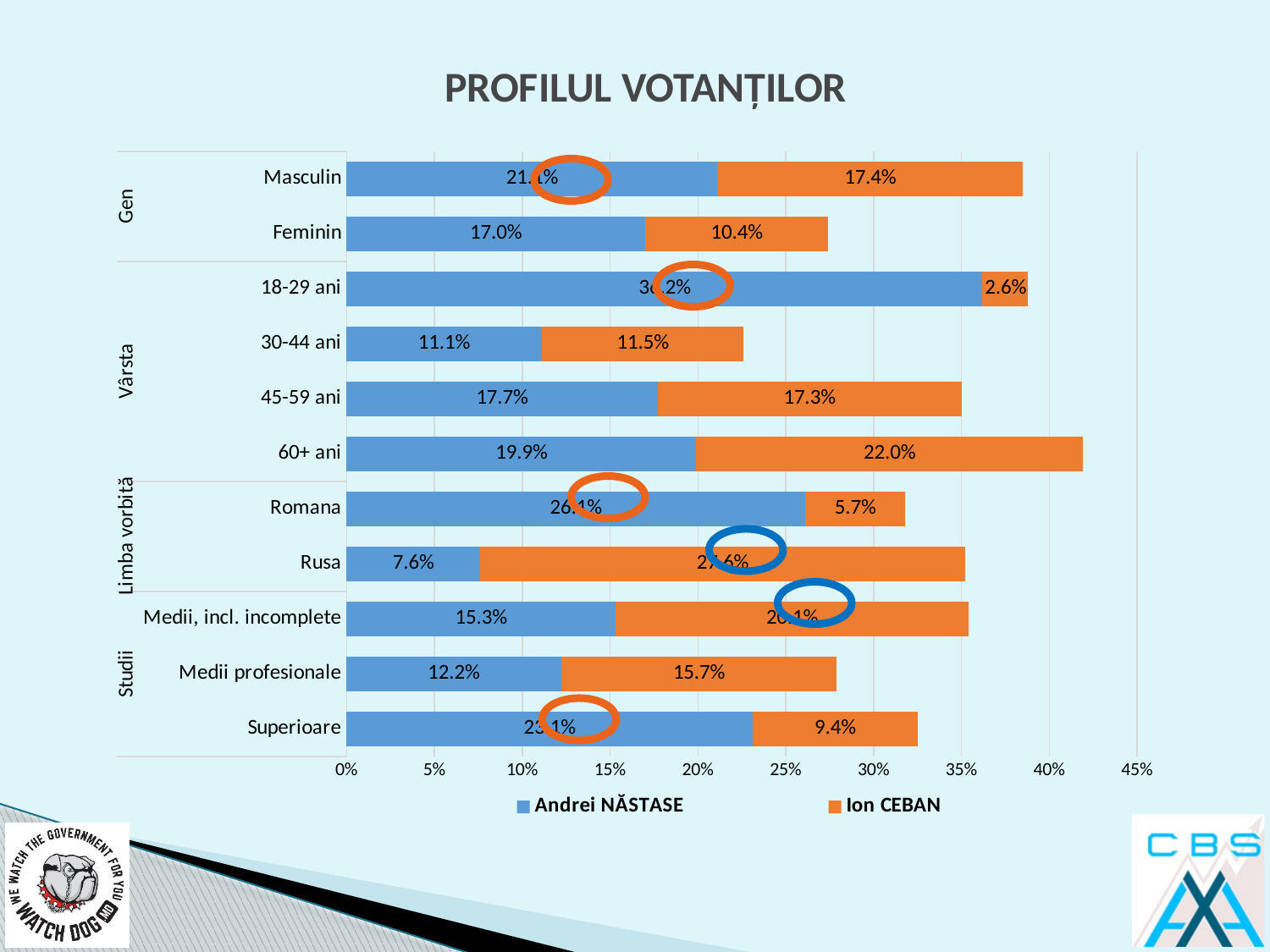
What is the value for Ion CEBAN in the 60+ ani category? 22.0% What is the value for Andrei NĂSTASE in the Feminin category? 17.0% In which category does Andrei NĂSTASE have the lowest value? Rusa In which category does Ion CEBAN have the lowest value? 18-29 ani How many series does the legend list? 2 What is the difference between Ion CEBAN and Andrei NĂSTASE in the 60+ ani category? 2.1 percentage points What is the value for Ion CEBAN in the 18-29 ani category? 2.6% In the 45-59 ani category, which series has the larger value, Andrei NĂSTASE or Ion CEBAN? Andrei NĂSTASE How many categories are shown on the chart? 11 What is the value for Ion CEBAN in the Medii profesionale category? 15.7% Is the value for Andrei NĂSTASE in the 18-29 ani category greater or less than 30%? greater What is the total of the stacked bar for Feminin? 27.4%